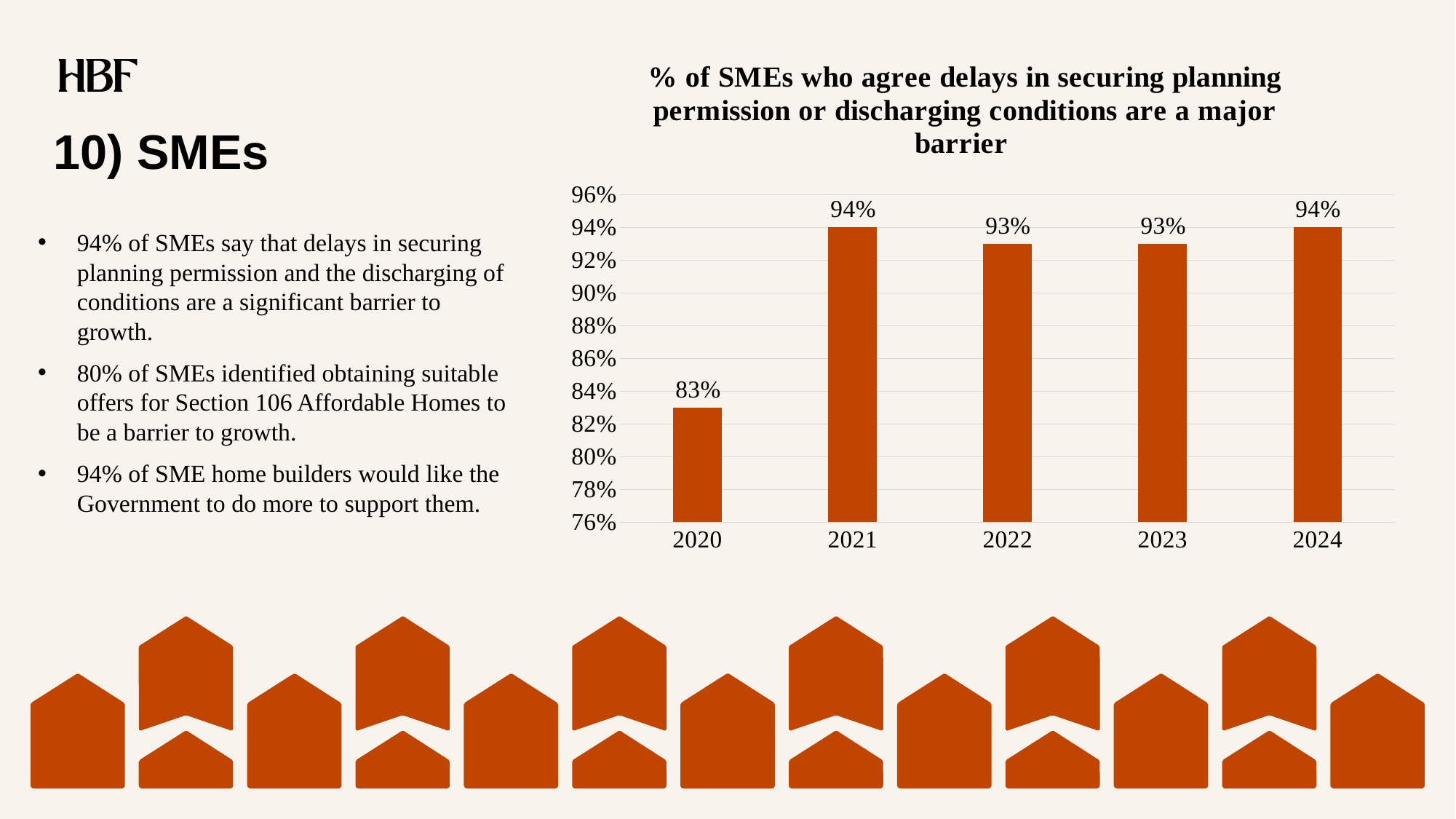
Does the value rise or fall from 2020 to 2021? rise Which is larger, the value for 2020 or the value for 2022? 2022 What is the value for 2022? 93% What is the difference between the values for 2024 and 2023? 1% Is the value for 2020 greater or less than 90%? less What kind of chart is shown? bar chart How many years are shown on the x axis? 5 Which year has the lowest value? 2020 What is the value for 2024? 94% What is the title of the chart? % of SMEs who agree delays in securing planning permission or discharging conditions are a major barrier What is the difference between the values for 2021 and 2020? 11% What is the value for 2020? 83%